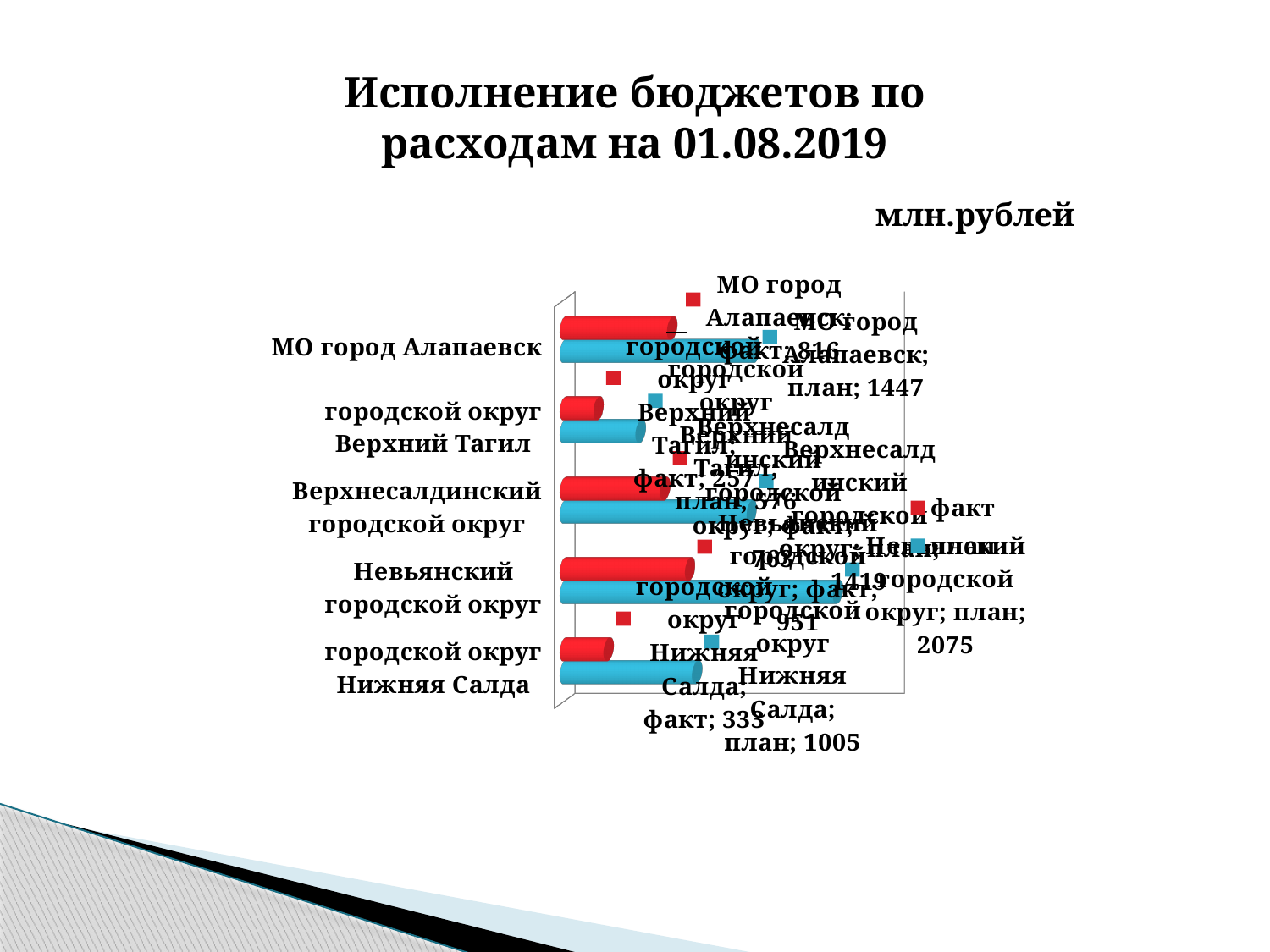
What is the план value for городской округ Верхний Тагил? 576 What is the difference between the план and факт values for МО город Алапаевск? 631 What is the план value for городской округ Нижняя Салда? 1005 What is the факт value for городской округ Верхний Тагил? 257 What is the план value for МО город Алапаевск? 1447 For городской округ Верхний Тагил, which is larger: the план value or the факт value? план What is the факт value for МО город Алапаевск? 816 What are the two series named in the legend? факт and план How many municipalities (categories) are shown on the chart? 5 What is the факт value for городской округ Нижняя Салда? 333 How many series does the chart legend list? 2 What kind of chart is shown on the slide? bar chart